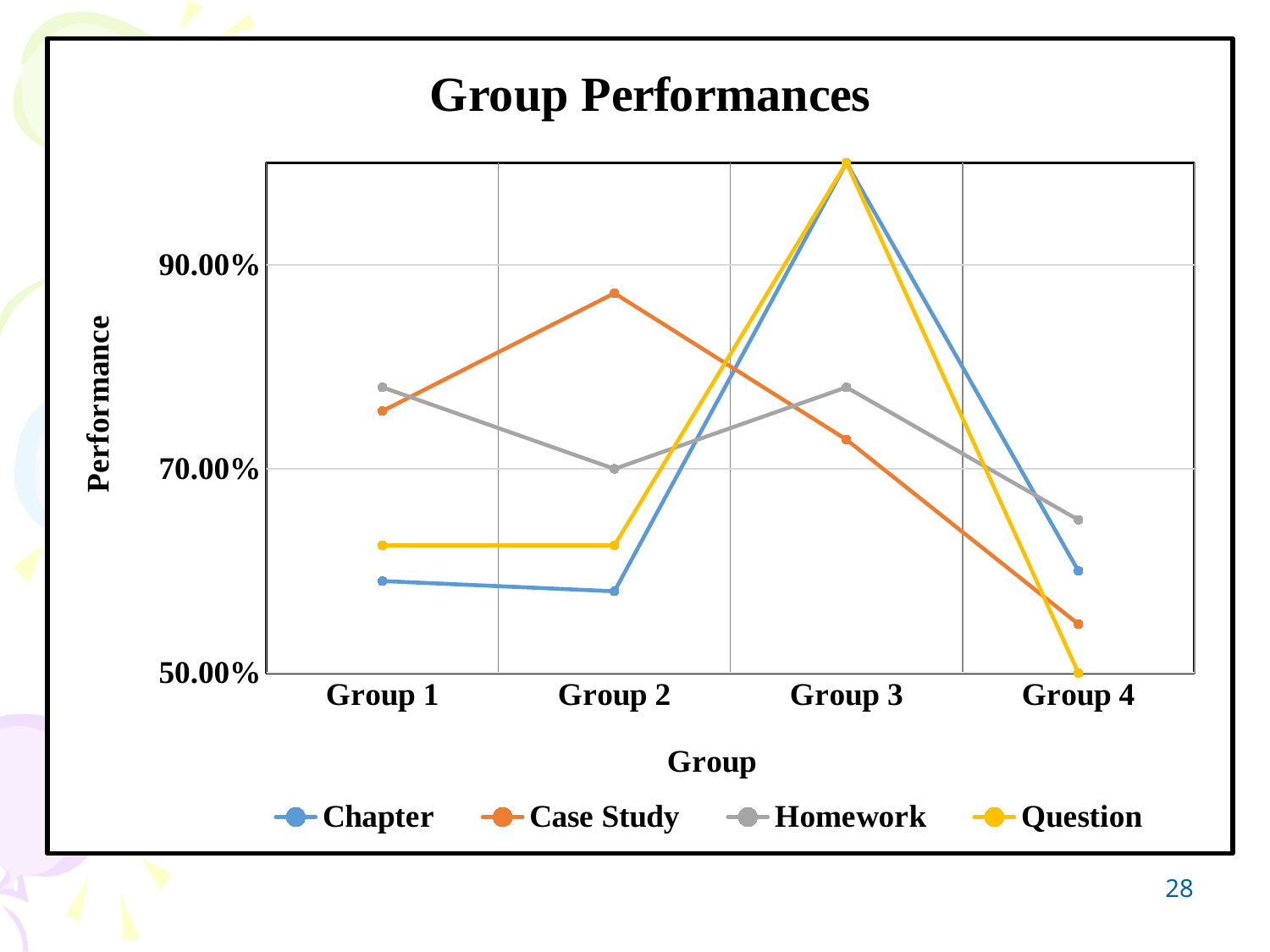
What is the Question value for Group 4? 50.00% For Group 1, which is larger: the Homework value or the Chapter value? Homework Does the Case Study line rise or fall from Group 2 to Group 4? fall How many groups are shown on the x axis? 4 For which group is the Homework value lowest? Group 4 How many series does the legend list? 4 Is the Chapter value for Group 1 greater or less than 70.00%? less Is the Case Study value for Group 2 greater or less than 70.00%? greater What kind of chart is shown on the slide? line chart Is the Case Study value for Group 4 greater or less than 70.00%? less What is the Homework value for Group 2? 70.00% For which group is the Case Study value highest? Group 2